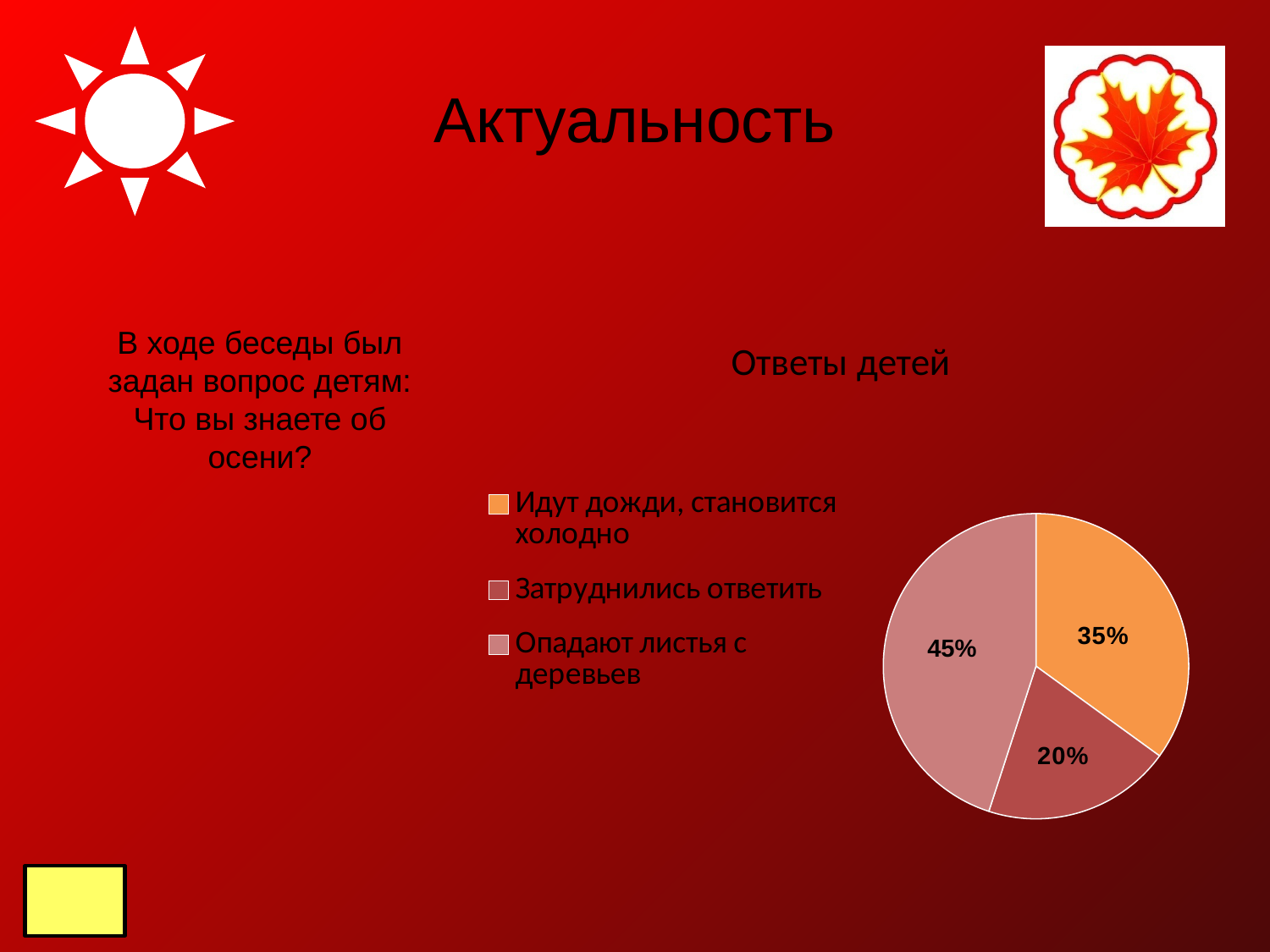
What is the difference between the shares for "Опадают листья с деревьев" and "Идут дожди, становится холодно"? 10% What share of the pie is labelled "Опадают листья с деревьев"? 45% Which category has the smallest slice of the pie? Затруднились ответить What kind of chart is shown on the slide? pie chart What share of the pie is labelled "Затруднились ответить"? 20% What share of the pie is labelled "Идут дожди, становится холодно"? 35% What is the title of the chart? Ответы детей How many entries does the legend list? 3 Which category has the largest slice of the pie? Опадают листья с деревьев How many slices does the pie chart have? 3 What colour is the slice for "Идут дожди, становится холодно"? orange Which is larger: the share for "Идут дожди, становится холодно" or the share for "Затруднились ответить"? Идут дожди, становится холодно